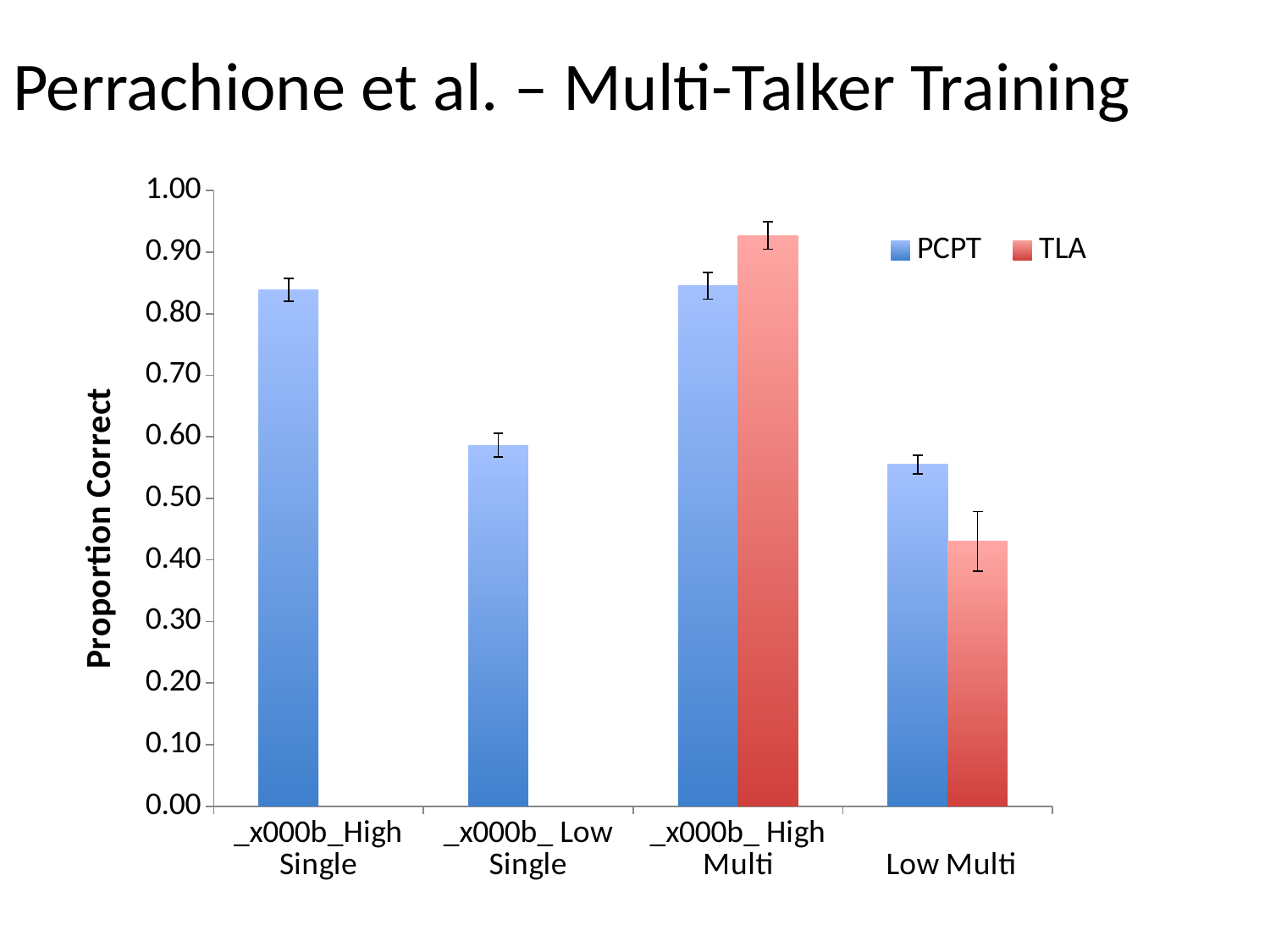
Which bar is the highest on the chart? TLA, High Multi Is the PCPT value for High Single greater or less than 0.80? greater Which bar is the lowest on the chart? TLA, Low Multi What kind of chart is shown on the slide? bar chart How many series does the legend list? 2 What is the label of the y axis? Proportion Correct Is the TLA value for Low Multi greater or less than 0.50? less Which series is shown in red? TLA For High Multi, which series has the larger value, PCPT or TLA? TLA For Low Multi, which series has the larger value, PCPT or TLA? PCPT How many categories are shown on the x axis? 4 Is the TLA value for High Multi greater or less than 0.90? greater